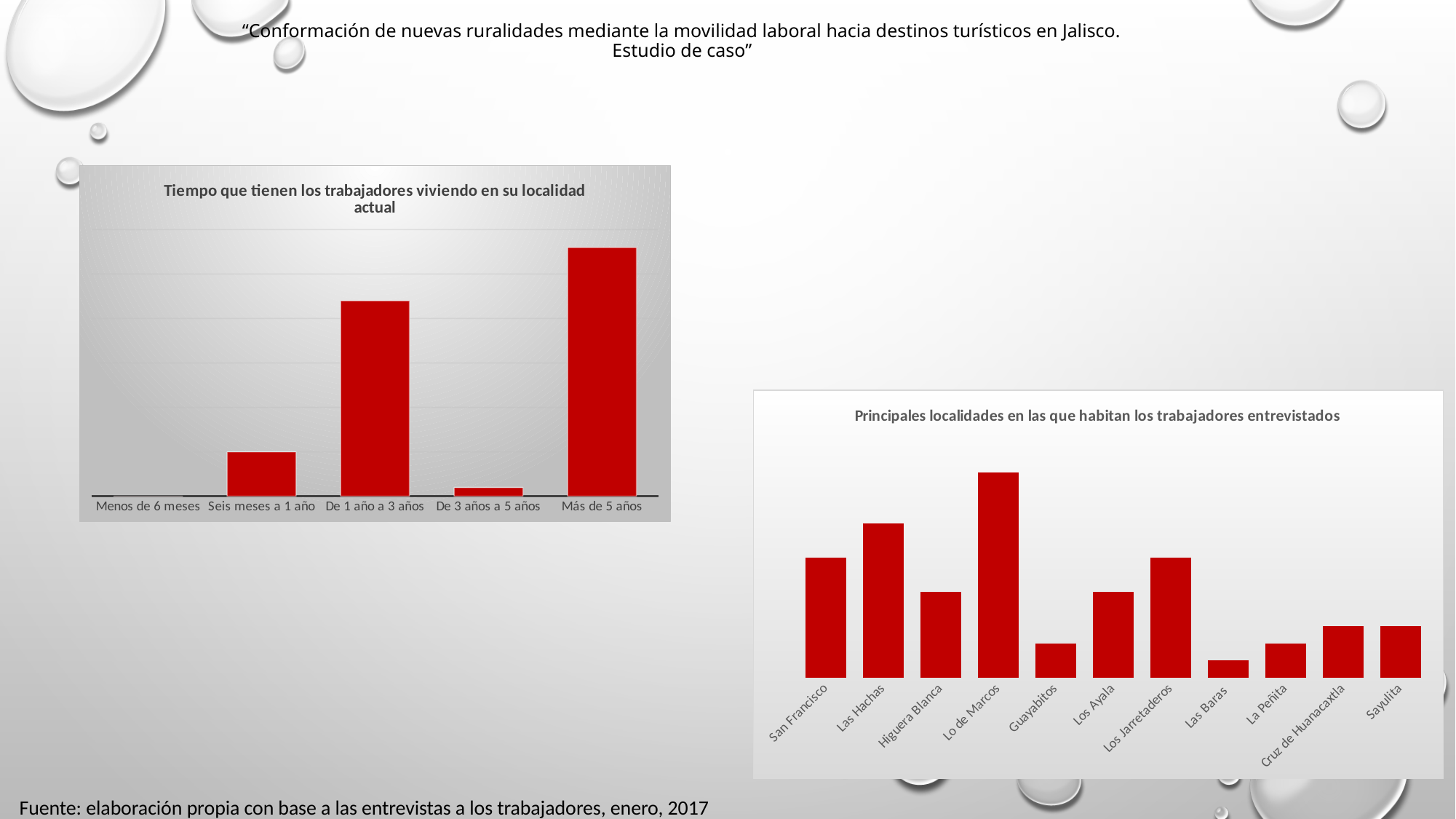
How many categories are shown in the chart 'Tiempo que tienen los trabajadores viviendo en su localidad actual'? 5 In the chart 'Tiempo que tienen los trabajadores viviendo en su localidad actual', which category has the lowest value? Menos de 6 meses In the chart 'Tiempo que tienen los trabajadores viviendo en su localidad actual', which is larger: 'De 1 año a 3 años' or 'Seis meses a 1 año'? De 1 año a 3 años In the chart 'Principales localidades en las que habitan los trabajadores entrevistados', which is larger: Las Hachas or San Francisco? Las Hachas How many localities are shown in the chart 'Principales localidades en las que habitan los trabajadores entrevistados'? 11 In the chart 'Tiempo que tienen los trabajadores viviendo en su localidad actual', which is larger: 'De 3 años a 5 años' or 'Seis meses a 1 año'? Seis meses a 1 año What colour are the bars in the chart 'Principales localidades en las que habitan los trabajadores entrevistados'? Red In the chart 'Tiempo que tienen los trabajadores viviendo en su localidad actual', which category has the highest value? Más de 5 años In the chart 'Principales localidades en las que habitan los trabajadores entrevistados', which locality has the highest value? Lo de Marcos What type of chart is 'Tiempo que tienen los trabajadores viviendo en su localidad actual'? Bar chart In the chart 'Principales localidades en las que habitan los trabajadores entrevistados', which locality has the lowest value? Las Baras